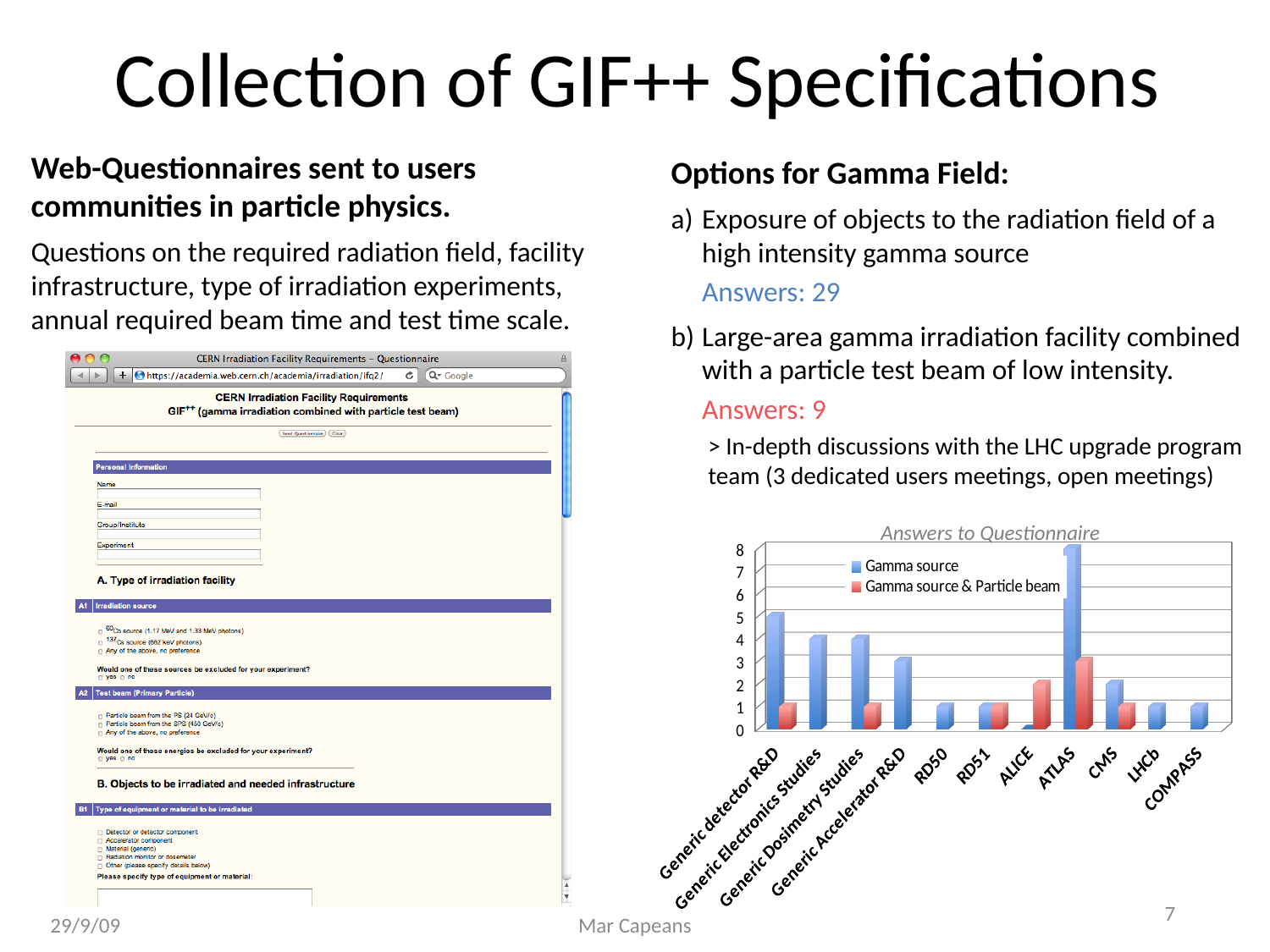
For the Gamma source series, which is larger: Generic detector R&D or CMS? Generic detector R&D What kind of chart is shown under the title "Answers to Questionnaire"? Bar chart Which category has the highest value for the Gamma source series in the "Answers to Questionnaire" chart? ATLAS Is the Gamma source value for Generic detector R&D greater or less than 3? greater Which category has the highest value for the Gamma source & Particle beam series in the "Answers to Questionnaire" chart? ATLAS Is the Gamma source value for Generic Accelerator R&D greater or less than 4? less What colour represents the Gamma source series in the "Answers to Questionnaire" chart? Blue How many categories are shown on the x axis of the "Answers to Questionnaire" chart? 11 For the Gamma source series, which is larger: ATLAS or Generic Electronics Studies? ATLAS How many series does the legend of the "Answers to Questionnaire" chart list? 2 Is the Gamma source value for ATLAS greater or less than 6? greater